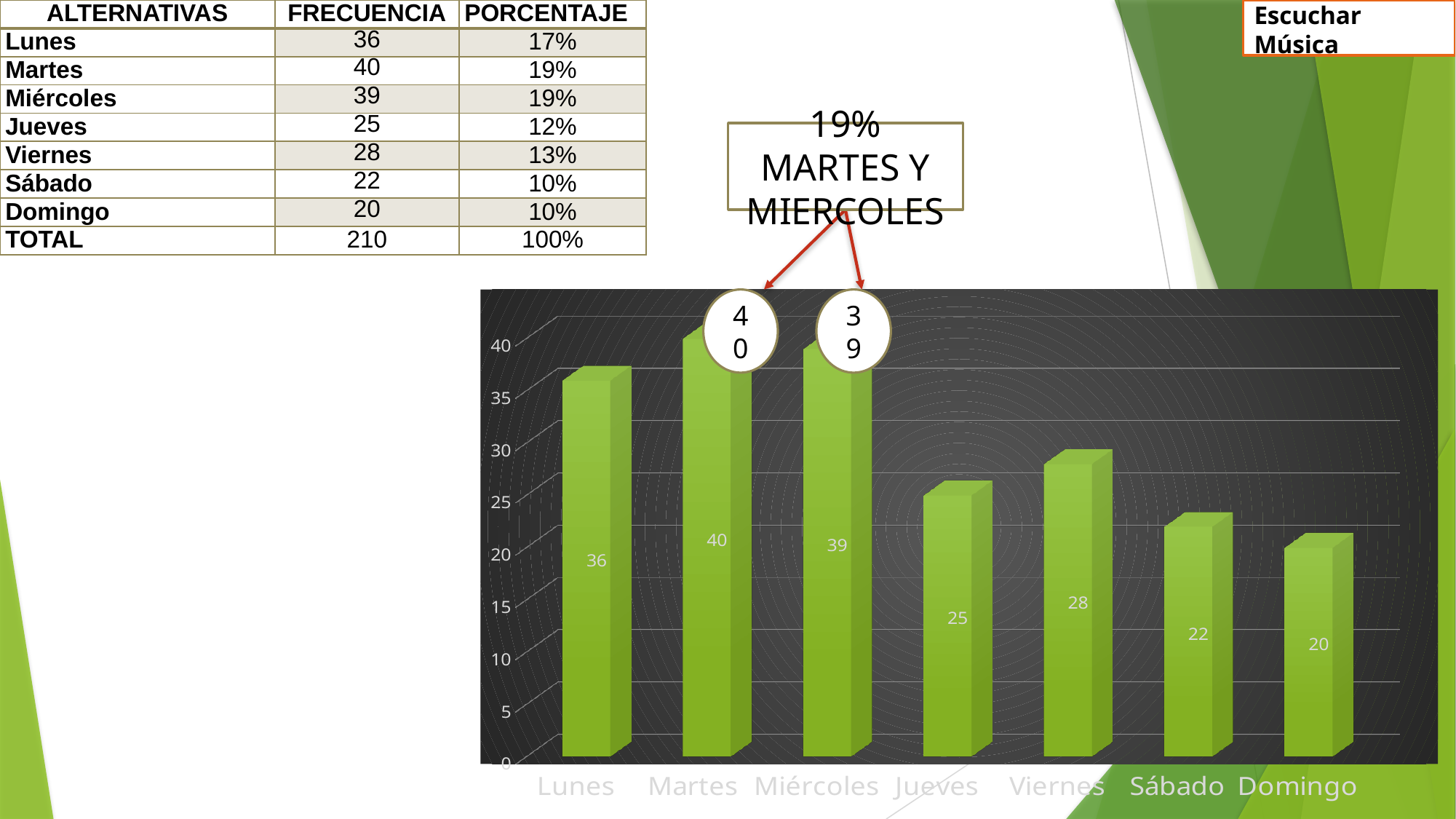
What is the difference between the values for Martes and Jueves? 15 What kind of chart is shown on the slide? bar chart Which day has the lowest value in the bar chart? Domingo What is the value for Viernes in the bar chart? 28 What is the difference between the values for Sábado and Domingo? 2 Is the value for Miércoles greater or less than 35? greater What is the value for Lunes in the bar chart? 36 What colour are the bars in the chart? green How many days are shown on the x axis of the bar chart? 7 Which is larger, the value for Jueves or the value for Viernes? Viernes What is the value for Domingo in the bar chart? 20 Which day has the highest value in the bar chart? Martes